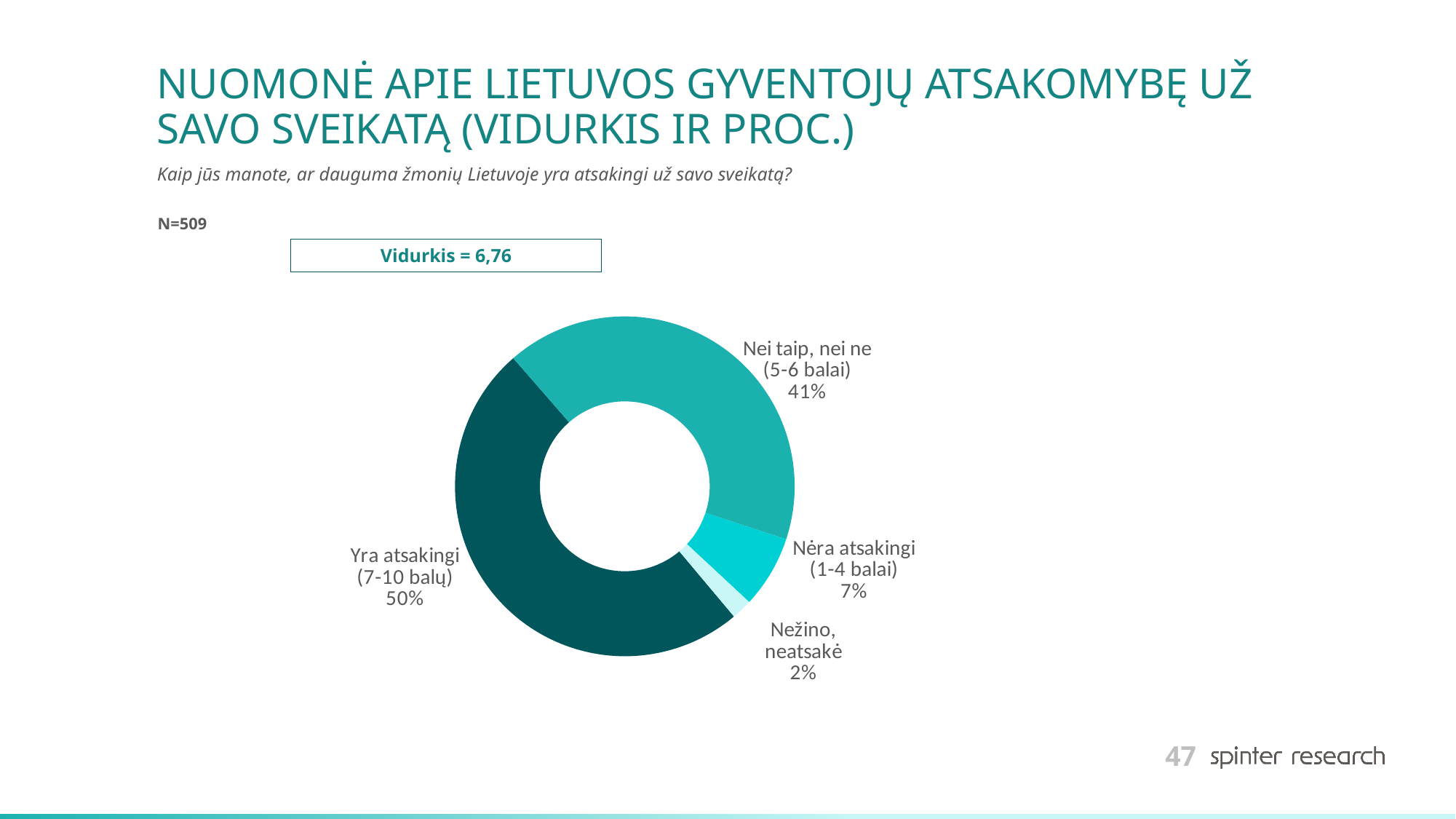
What share of respondents answered "Nėra atsakingi (1-4 balai)"? 7% Which category has the smallest share of the chart? Nežino, neatsakė How many categories are shown in the chart? 4 What is the average (Vidurkis) value shown on the slide? 6,76 What is the difference in percentage points between "Yra atsakingi (7-10 balų)" and "Nei taip, nei ne (5-6 balai)"? 9 percentage points What kind of chart is shown on the slide? Doughnut (pie) chart What is the sample size (N) shown on the slide? 509 Which is larger: the share for "Nėra atsakingi (1-4 balai)" or the share for "Nežino, neatsakė"? Nėra atsakingi (1-4 balai) What share of respondents answered "Nežino, neatsakė"? 2% What share of respondents answered "Nei taip, nei ne (5-6 balai)"? 41% Which category has the largest share of the chart? Yra atsakingi (7-10 balų) What share of respondents answered "Yra atsakingi (7-10 balų)"? 50%